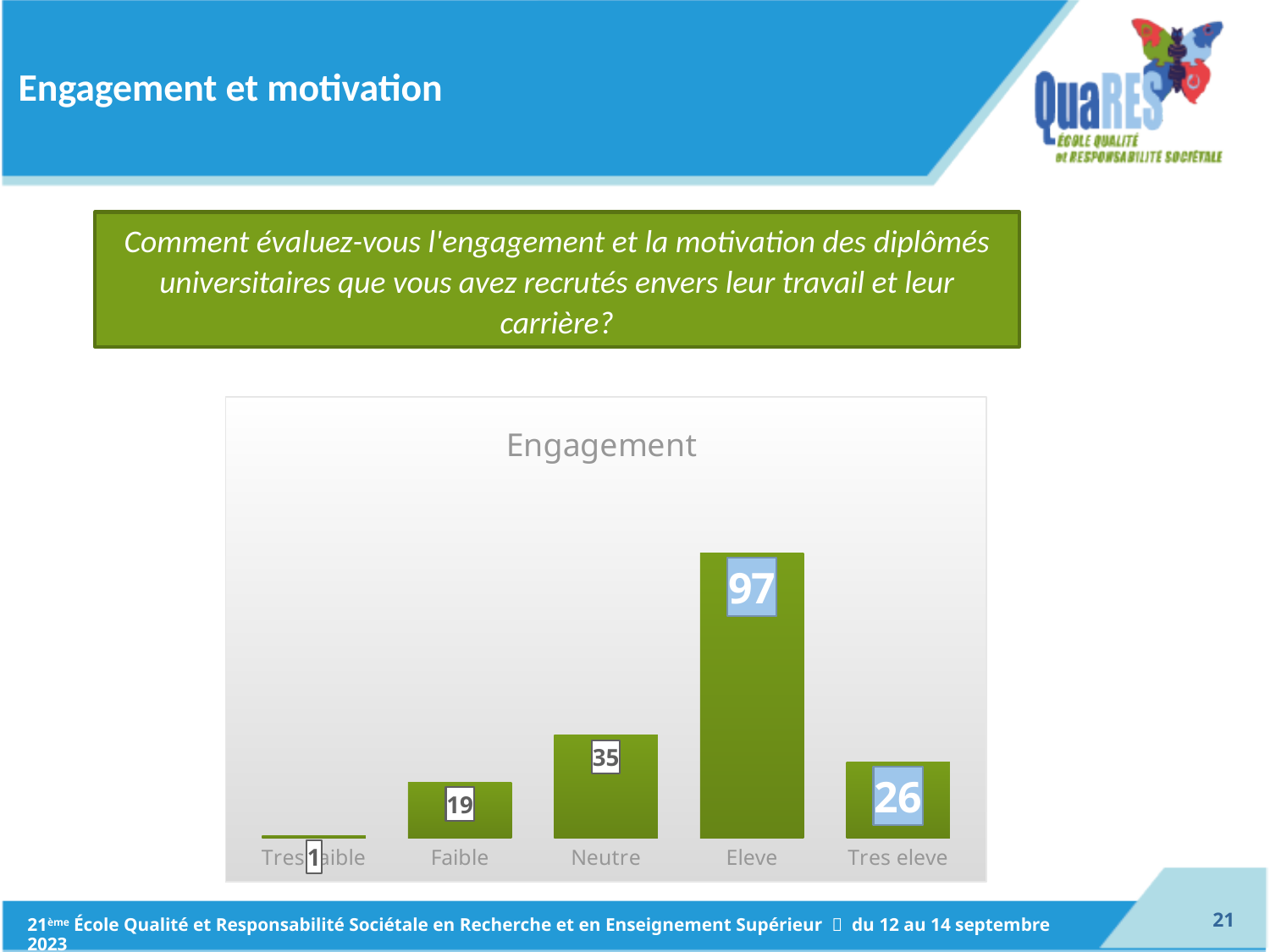
What is the value for Tres faible in the Engagement chart? 1 What is the difference between the values for Eleve and Neutre? 62 What is the value for Tres eleve in the Engagement chart? 26 Which category has the lowest value in the Engagement chart? Tres faible Which is larger, the value for Neutre or the value for Tres eleve? Neutre How many categories are shown in the Engagement chart? 5 What is the value for Faible in the Engagement chart? 19 What kind of chart is shown on the slide? Bar chart What is the difference between the values for Tres eleve and Faible? 7 Which category has the highest value in the Engagement chart? Eleve What is the value for Eleve in the Engagement chart? 97 What is the value for Neutre in the Engagement chart? 35